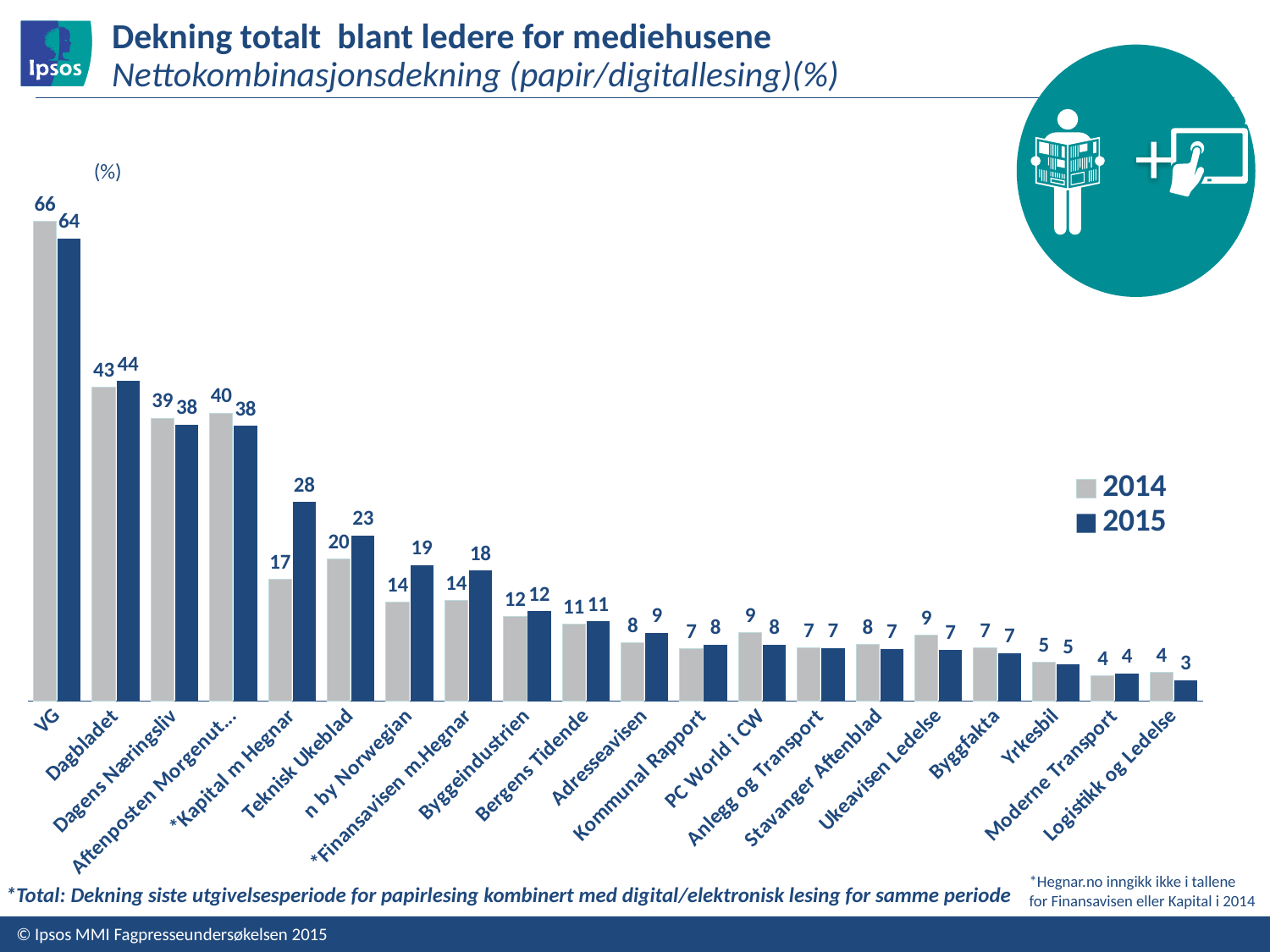
Do the 2014 values generally rise or fall from left to right along the x axis? Fall What is the 2014 value for *Kapital m Hegnar? 17 Which is larger for Dagbladet, the 2014 value or the 2015 value? 2015 What are the two entries in the chart legend? 2014 and 2015 How many categories are shown on the x axis? 20 What is the difference between the 2015 and 2014 values for *Kapital m Hegnar? 11 Which category has the lowest 2015 value? Logistikk og Ledelse What is the 2015 value for VG? 64 What kind of chart is shown on the slide? Bar chart Which category has the highest 2014 value? VG What is the 2015 value for Teknisk Ukeblad? 23 How many series does the legend list? 2